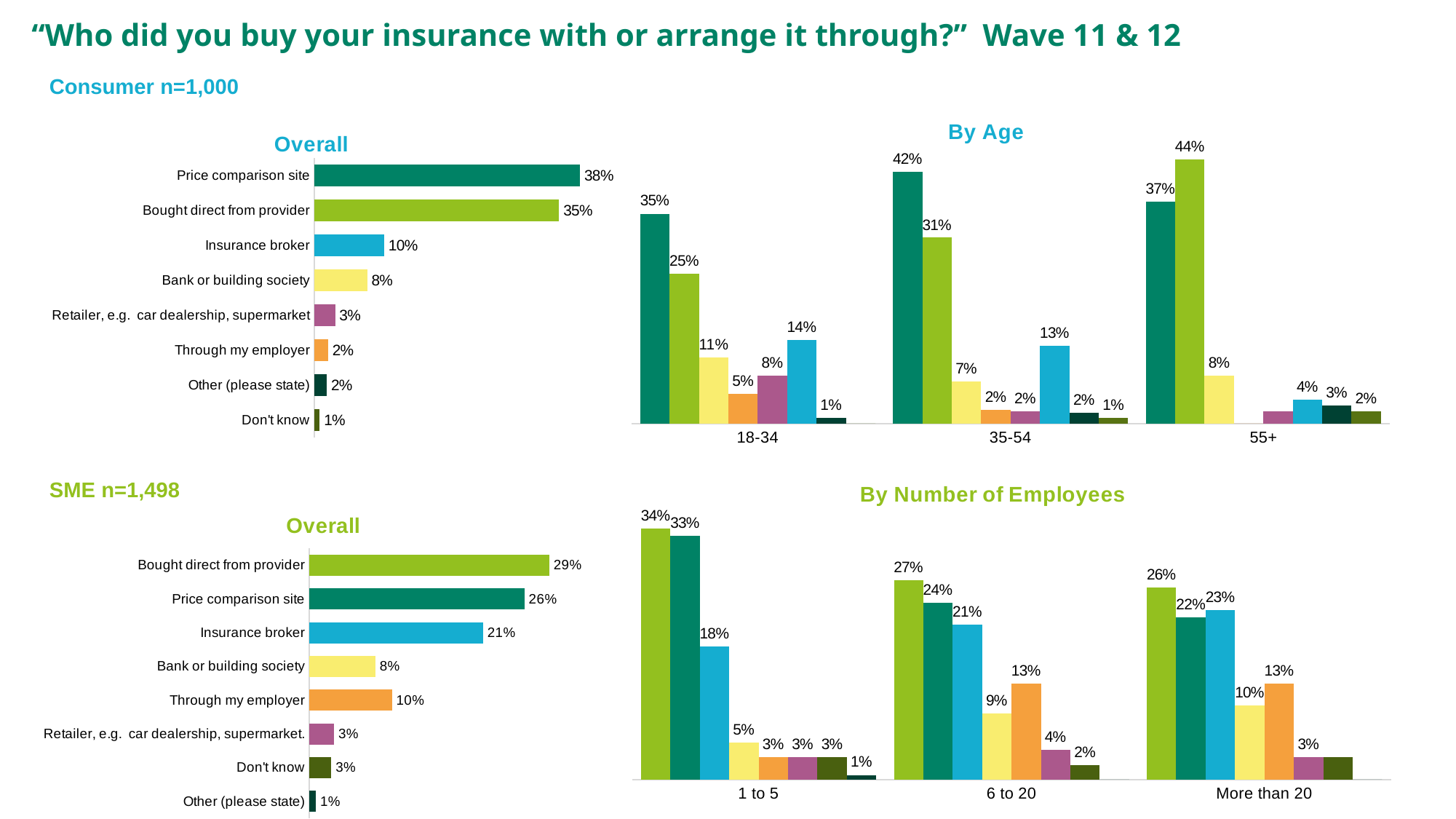
What kind of chart is the Consumer Overall chart? Bar chart How many age groups are shown on the x axis of the By Age chart? 3 In the Consumer Overall chart, which category has the highest value? Price comparison site In the By Age chart, what is the highest value shown for the 55+ group? 44% In the SME Overall chart, which is larger: Through my employer or Bank or building society? Through my employer In the SME Overall chart, what is the value for Insurance broker? 21% In the By Number of Employees chart, what is the highest value shown for the 1 to 5 group? 34% In the Consumer Overall chart, which category has the lowest value? Don't know In the Consumer Overall chart, what is the difference between Price comparison site and Bought direct from provider? 3 percentage points How many categories are shown in the SME Overall chart? 8 In the Consumer Overall chart, what is the value for Price comparison site? 38%